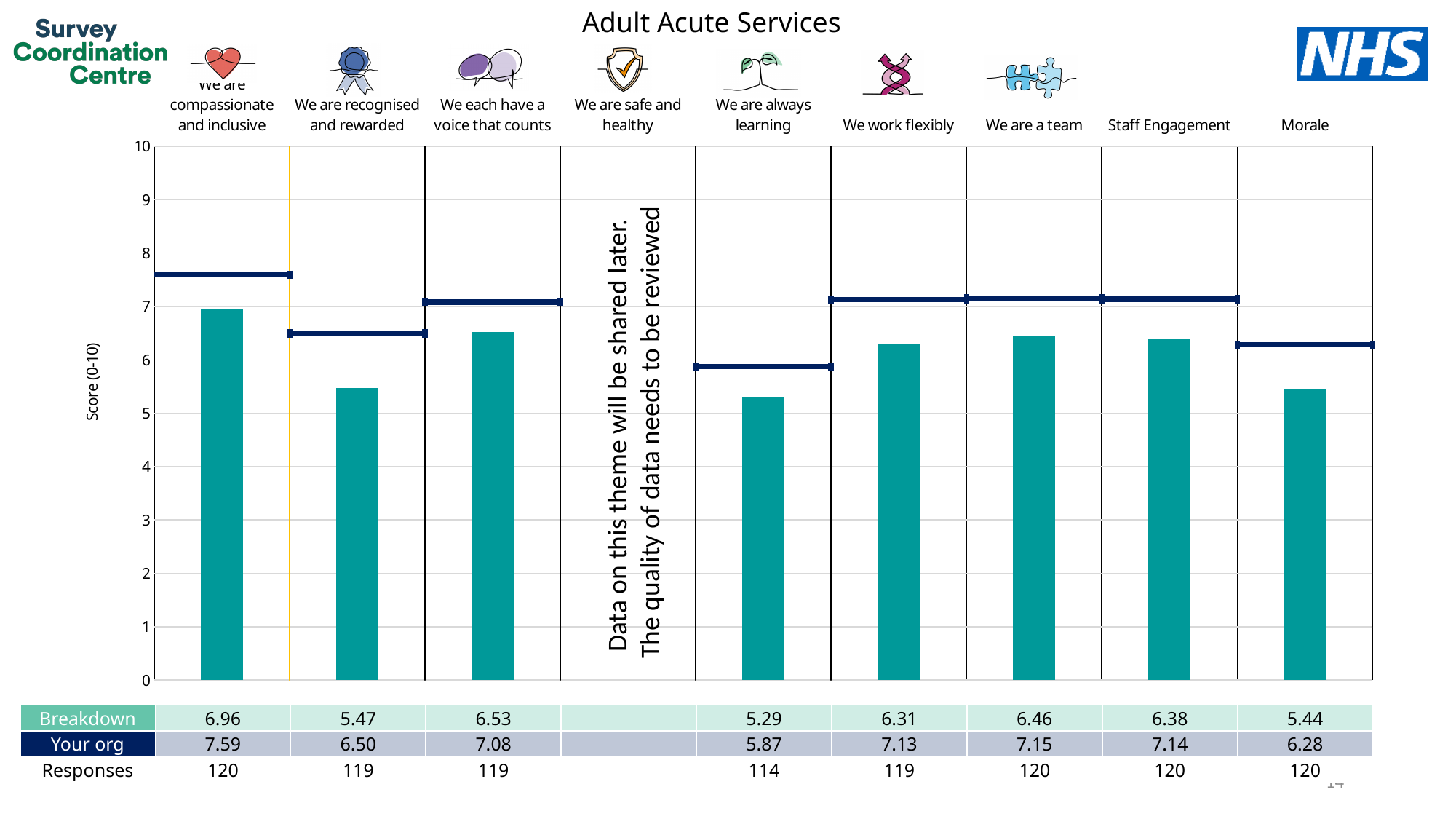
What is the Your org score for 'We are always learning'? 5.87 What is the Breakdown score for 'We are compassionate and inclusive'? 6.96 Which theme has the highest Breakdown score? We are compassionate and inclusive What is the title of the chart? Adult Acute Services How many themes have a Breakdown bar plotted on the chart? 8 Which theme has the lowest Breakdown score? We are always learning Which theme has no data shown on the chart? We are safe and healthy Which has the higher Breakdown score: 'We are a team' or 'Staff Engagement'? We are a team What is the difference between the Your org score and the Breakdown score for 'We are compassionate and inclusive'? 0.63 What kind of chart is shown on the slide? bar chart Is the Breakdown bar for 'Morale' greater or less than 6? less How many responses are recorded for 'We are always learning'? 114